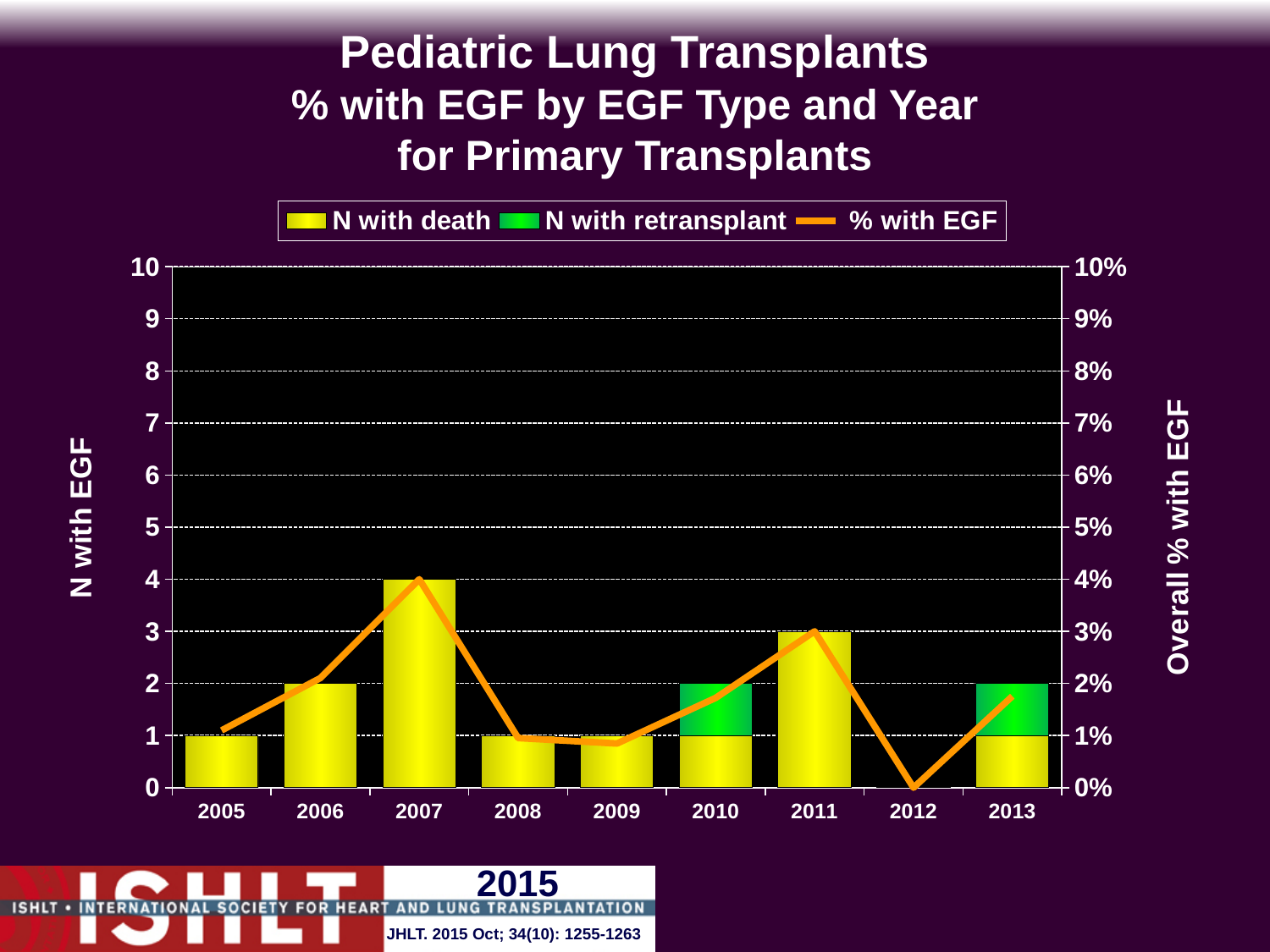
How many years are shown along the x axis? 9 What kind of chart is shown on the slide? A combined bar and line chart Is the % with EGF value for 2005 greater or less than 2%? less Does the % with EGF line rise or fall from 2011 to 2012? fall Which year has no bar at all (N with EGF of 0)? 2012 What is the total height of the stacked bar in 2010? 2 What is the total height of the stacked bar in 2013? 2 What is the value of N with death in 2007? 4 How many series does the legend list? 3 Which is larger, the bar for 2007 or the bar for 2011? 2007 What colour represents N with retransplant in the legend? Green Which year has the tallest bar for N with EGF? 2007